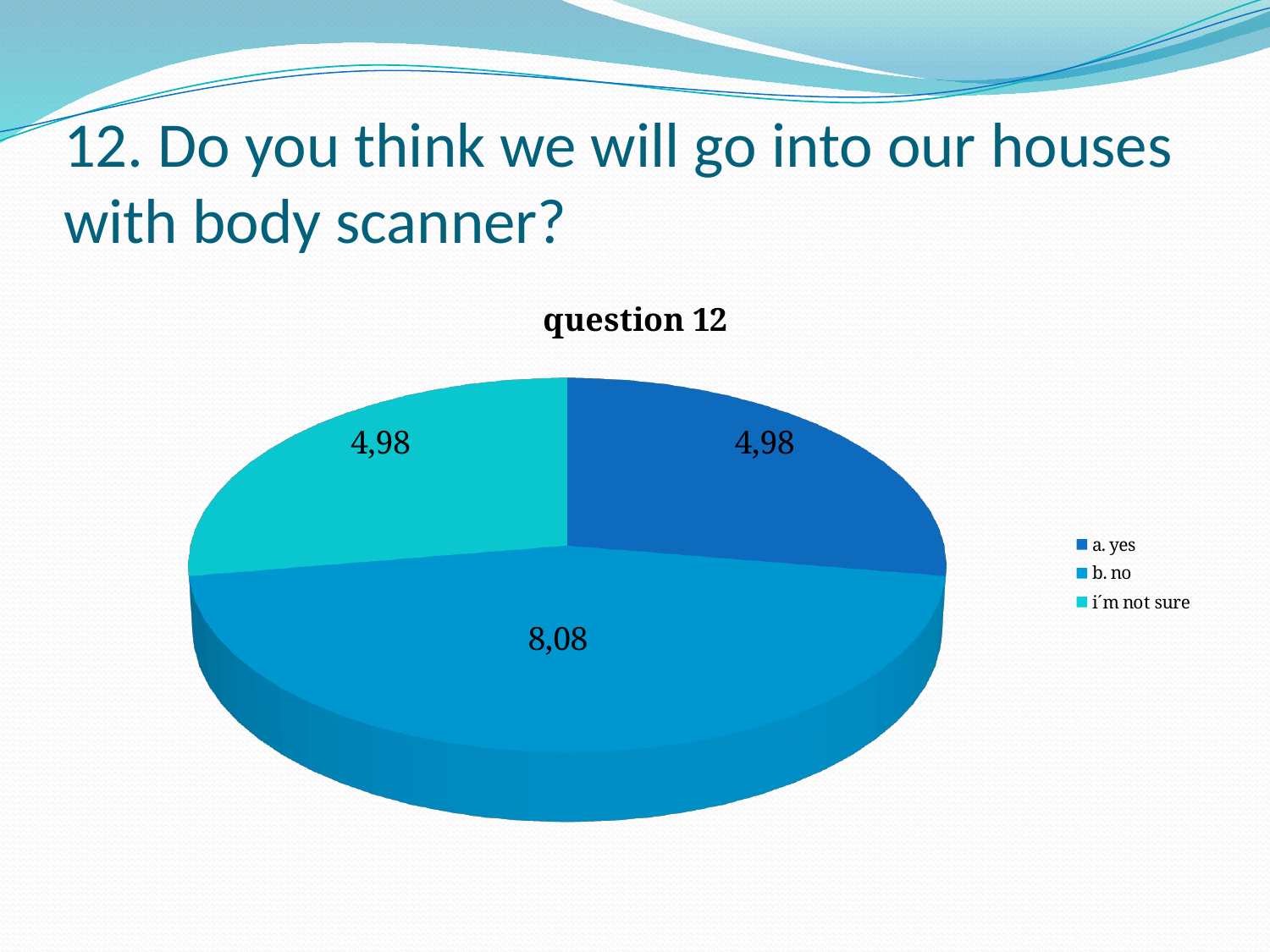
Are the values for "a. yes" and "i'm not sure" the same or different? the same What kind of chart is shown on the slide? pie chart What is the value shown for the "a. yes" slice in the pie chart? 4,98 What is the value shown for the "b. no" slice in the pie chart? 8,08 How many slices does the pie chart have? 3 What is the difference between the values for "b. no" and "a. yes"? 3,10 What is the title of the chart? question 12 How many entries does the chart legend list? 3 What is the value shown for the "i'm not sure" slice in the pie chart? 4,98 Which category has the largest slice in the pie chart? b. no Which legend entry is shown in the darkest blue colour? a. yes Which is larger, the value for "b. no" or the value for "i'm not sure"? b. no